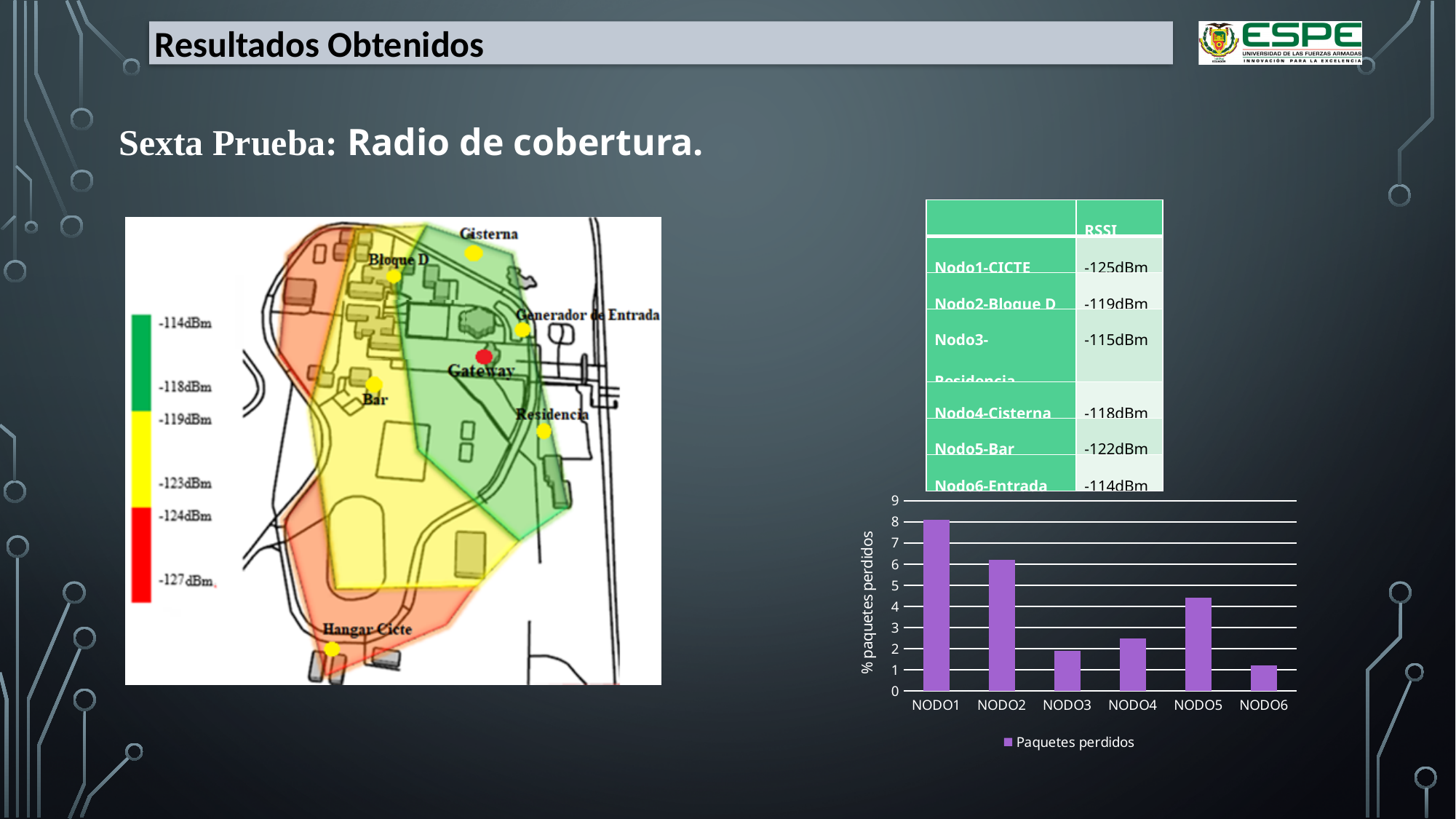
Which node has the lowest percentage of lost packets in the bar chart? NODO6 Which node has the highest percentage of lost packets in the bar chart? NODO1 Do the values rise or fall from NODO1 to NODO3 in the bar chart? fall Is the value for NODO5 greater or less than 5? less How many series does the legend of the bar chart list? 1 What is the label on the y axis of the bar chart? % paquetes perdidos What kind of chart is shown on the slide? bar chart Which has a higher percentage of lost packets, NODO2 or NODO5? NODO2 Is the value for NODO3 greater or less than 3? less How many categories (nodes) are shown on the x axis of the bar chart? 6 Is the value for NODO2 greater or less than 5? greater